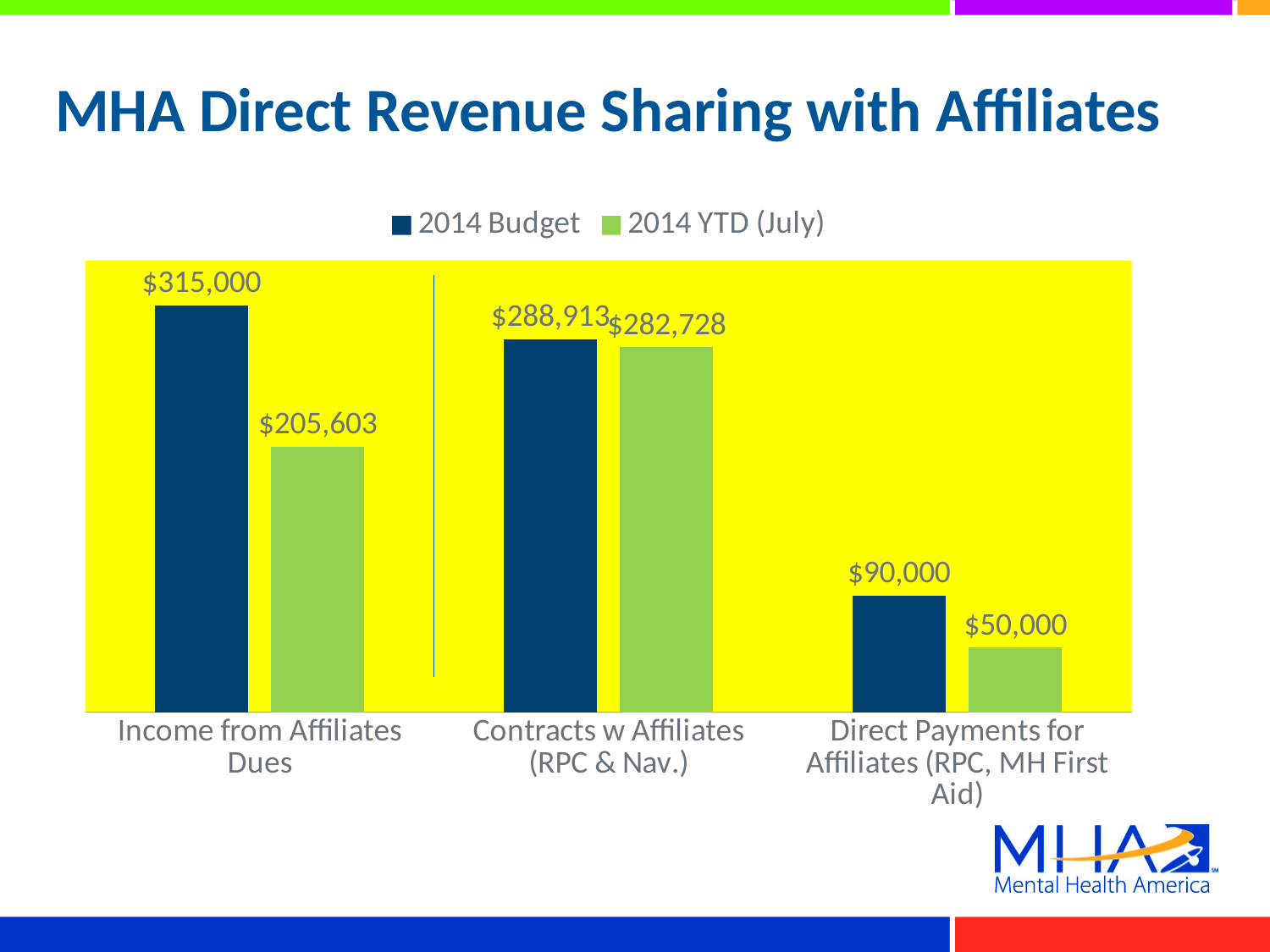
Which category has the highest 2014 Budget value? Income from Affiliates Dues How many categories are shown on the x axis? 3 What is the difference between the 2014 Budget and 2014 YTD (July) values for Income from Affiliates Dues? $109,397 What kind of chart is shown on the slide? Bar chart Which category has the lowest 2014 YTD (July) value? Direct Payments for Affiliates (RPC, MH First Aid) What is the difference between the 2014 Budget and 2014 YTD (July) values for Direct Payments for Affiliates (RPC, MH First Aid)? $40,000 What is the 2014 YTD (July) value for Direct Payments for Affiliates (RPC, MH First Aid)? $50,000 What is the 2014 Budget value for Income from Affiliates Dues? $315,000 How many series does the legend list? 2 What is the 2014 YTD (July) value for Contracts w Affiliates (RPC & Nav.)? $282,728 Which is larger for Contracts w Affiliates (RPC & Nav.): the 2014 Budget or the 2014 YTD (July) value? 2014 Budget What colour are the 2014 YTD (July) bars? Green